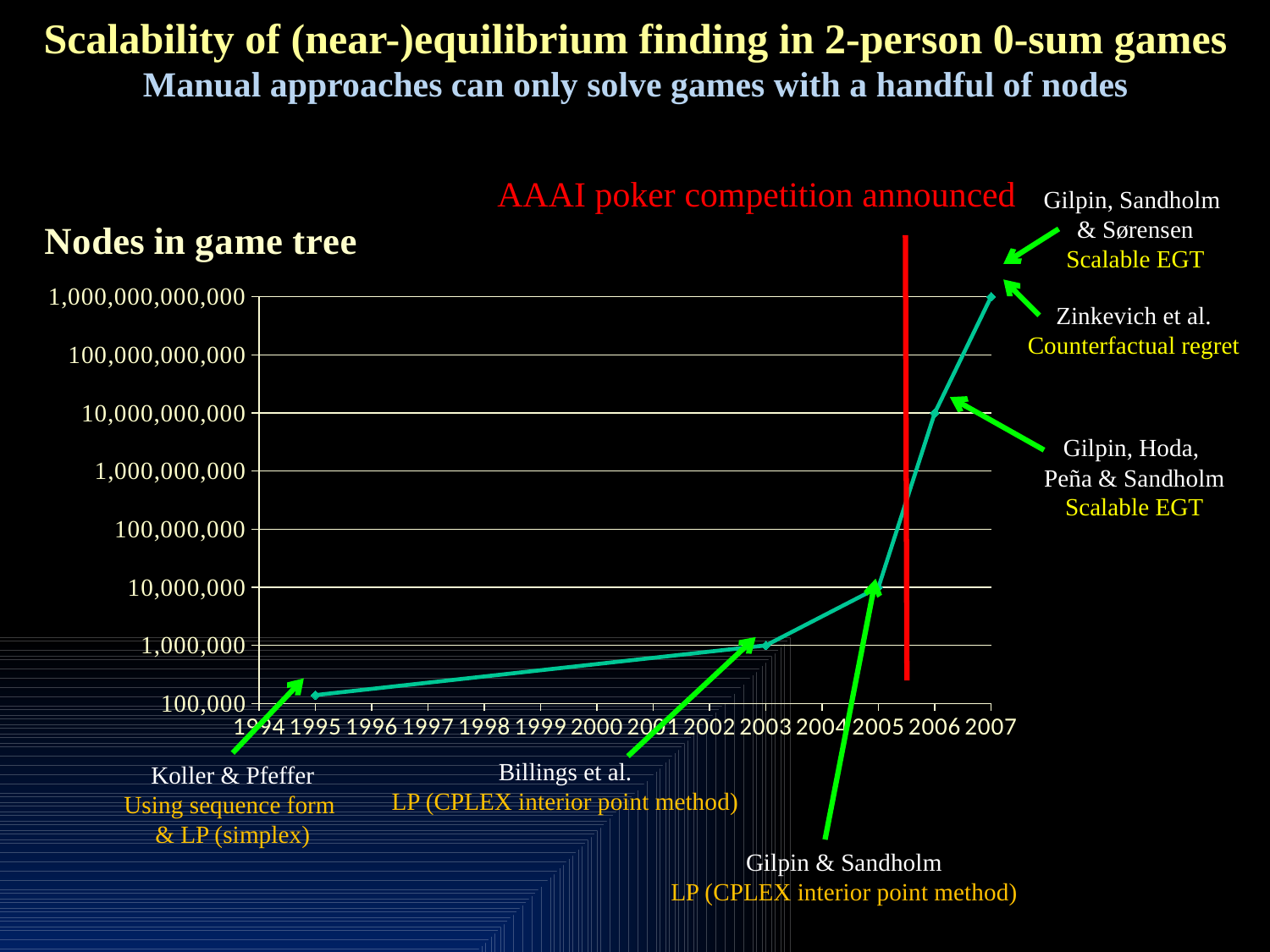
Do the values in the chart rise or fall as the years increase along the x axis? rise What is the label of the y axis of the chart? Nodes in game tree Which year has the highest number of nodes in the game tree? 2007 What event does the red vertical line in the chart mark? AAAI poker competition announced Is the value for 2003 greater or less than 10,000,000? less Which year has the lowest number of nodes in the game tree? 1995 Is the value for 2007 greater or less than 100,000,000,000? greater Is the value for 1995 greater or less than 1,000,000? less Which year has a larger value, 2006 or 2003? 2006 What kind of chart is shown on the slide? line chart How many data points are plotted on the line? 5